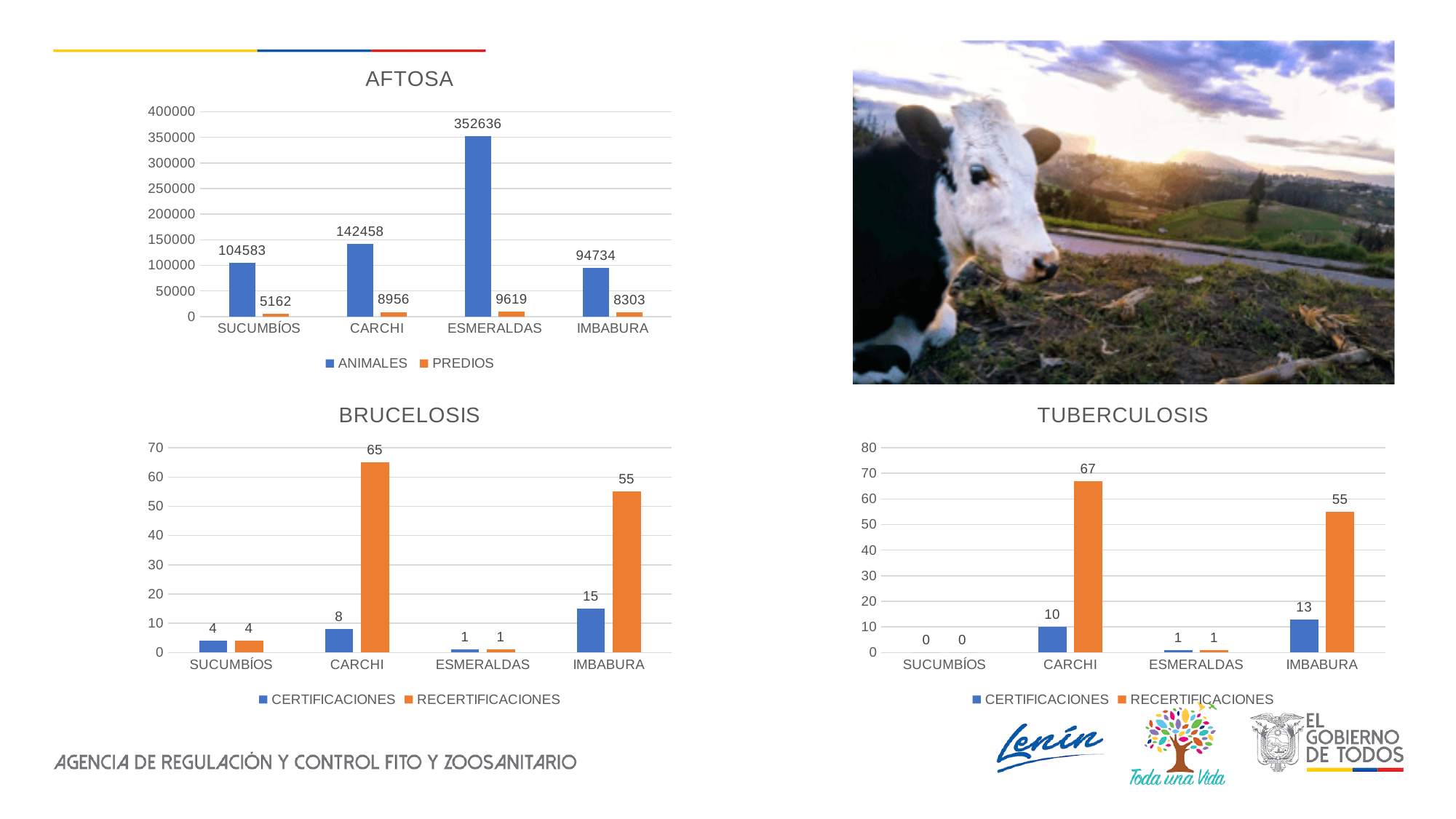
In the AFTOSA chart, what is the ANIMALES value for ESMERALDAS? 352636 In the AFTOSA chart, what is the difference between the ANIMALES values for CARCHI and SUCUMBÍOS? 37875 In the AFTOSA chart, what is the PREDIOS value for CARCHI? 8956 In the AFTOSA chart, which province has the lowest PREDIOS value? SUCUMBÍOS In the BRUCELOSIS chart, which province has the highest CERTIFICACIONES value? IMBABURA In the TUBERCULOSIS chart, how many series does the legend list? 2 In the TUBERCULOSIS chart, what is the difference between the RECERTIFICACIONES values for CARCHI and IMBABURA? 12 What kind of chart is the AFTOSA chart? Bar chart In the TUBERCULOSIS chart, what is the CERTIFICACIONES value for CARCHI? 10 In the BRUCELOSIS chart, what is the RECERTIFICACIONES value for CARCHI? 65 In the BRUCELOSIS chart, how many provinces are shown on the x axis? 4 In the AFTOSA chart, which province has the highest ANIMALES value? ESMERALDAS